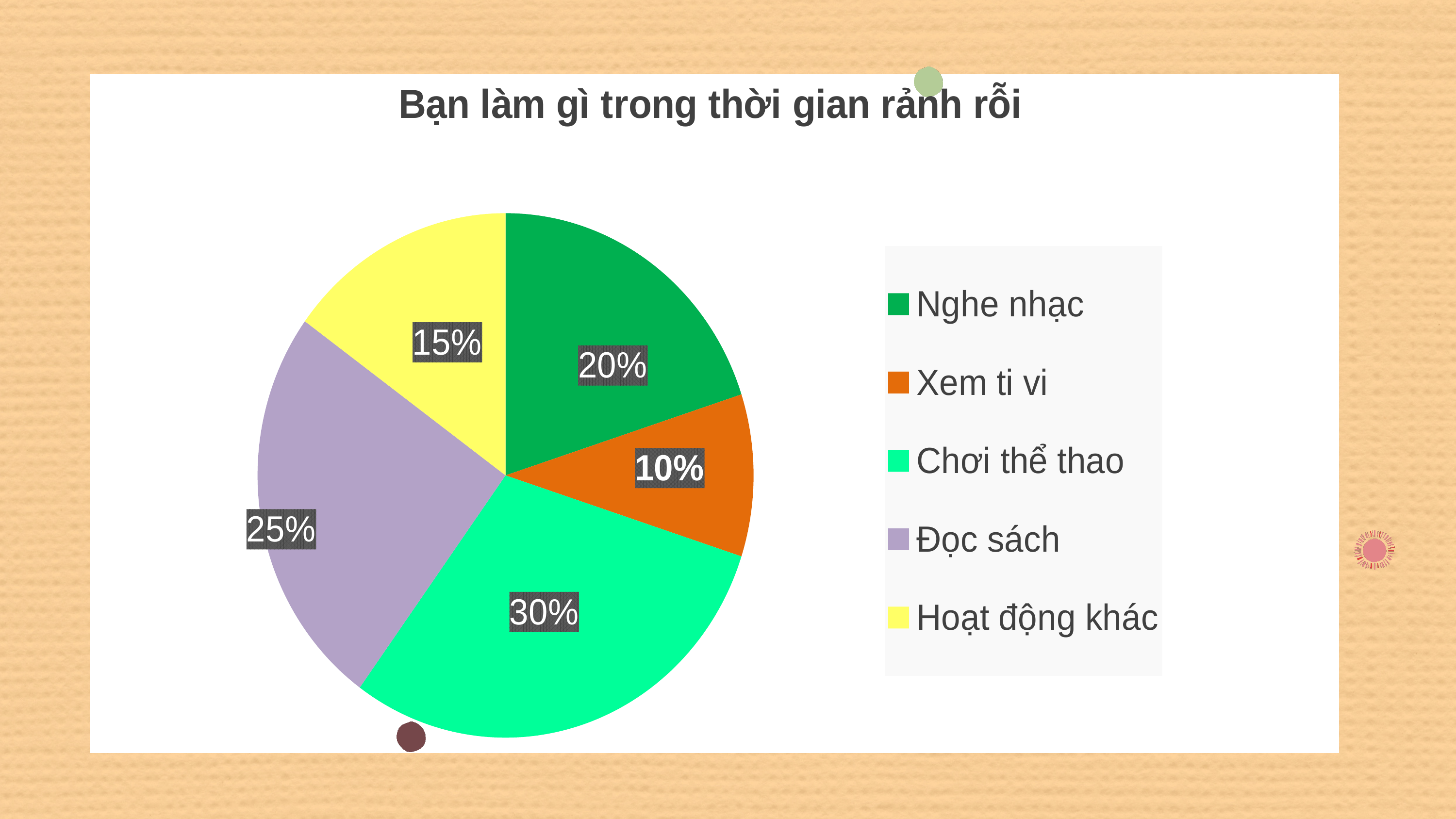
Which category has the largest share of the pie? Chơi thể thao What percentage of the pie is Nghe nhạc? 20% What is the title of the chart? Bạn làm gì trong thời gian rảnh rỗi What percentage of the pie is Chơi thể thao? 30% How many categories does the pie chart show? 5 Which is larger, the share for Đọc sách or the share for Hoạt động khác? Đọc sách What percentage of the pie is Xem ti vi? 10% What percentage of the pie is Đọc sách? 25% What kind of chart is shown on the slide? pie chart What is the difference between the shares of Chơi thể thao and Nghe nhạc? 10% What percentage of the pie is Hoạt động khác? 15% Which category has the smallest share of the pie? Xem ti vi